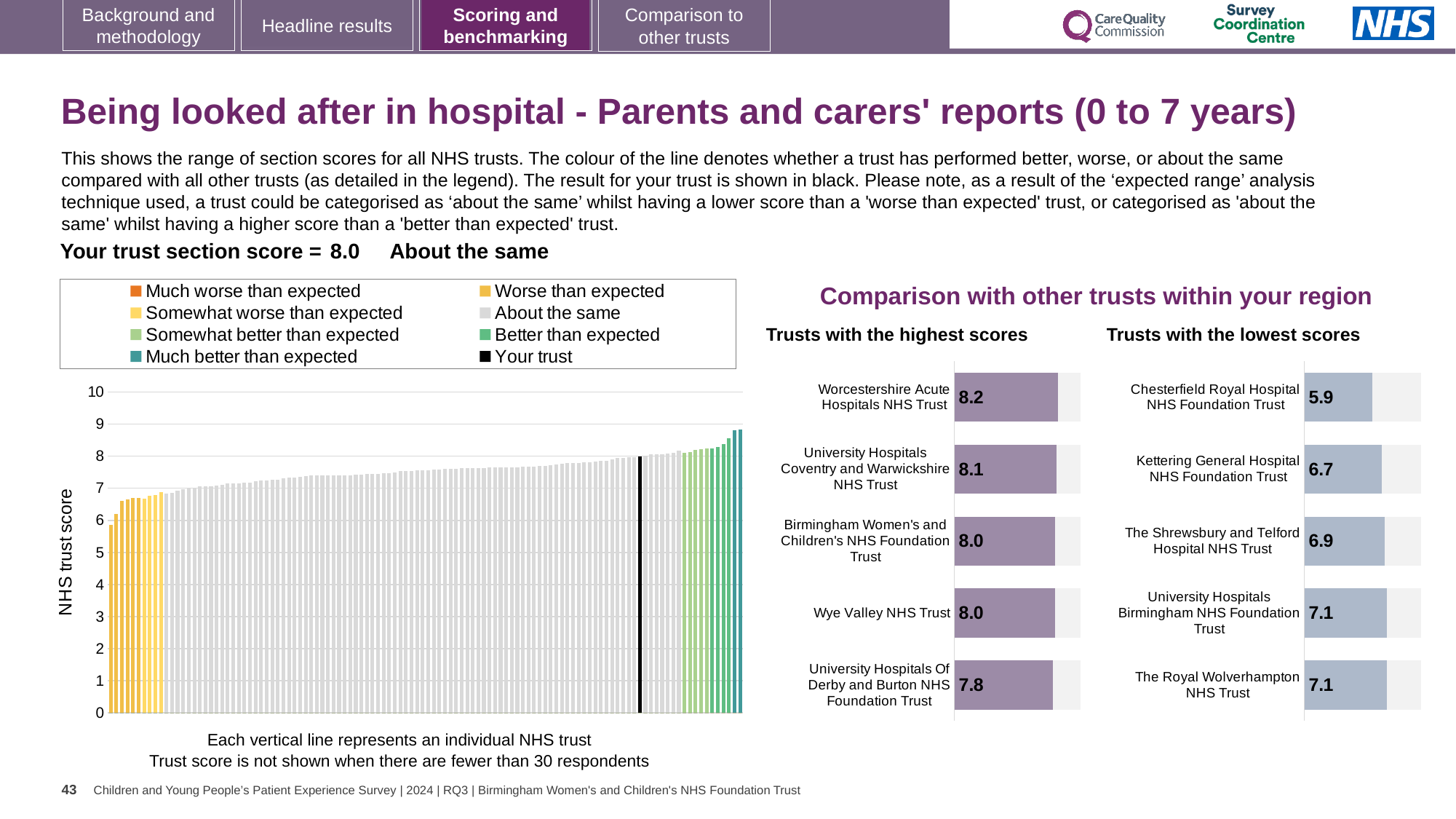
How many trusts are shown in the 'Trusts with the lowest scores' chart? 5 In the 'Trusts with the lowest scores' chart, what is the difference between the scores of Kettering General Hospital NHS Foundation Trust and Chesterfield Royal Hospital NHS Foundation Trust? 0.8 In the 'Trusts with the highest scores' chart, what is the score for Worcestershire Acute Hospitals NHS Trust? 8.2 What kind of chart is the large chart on the left showing NHS trust scores? Bar chart In the 'Trusts with the lowest scores' chart, what is the score for Kettering General Hospital NHS Foundation Trust? 6.7 In the 'Trusts with the highest scores' chart, which trust has the highest score? Worcestershire Acute Hospitals NHS Trust In the 'Trusts with the lowest scores' chart, which has the higher score: Kettering General Hospital NHS Foundation Trust or The Shrewsbury and Telford Hospital NHS Trust? The Shrewsbury and Telford Hospital NHS Trust In the large chart on the left, is the value of the tallest bar greater or less than 8? greater How many entries does the legend of the large chart on the left list? 8 In the 'Trusts with the lowest scores' chart, which trust has the lowest score? Chesterfield Royal Hospital NHS Foundation Trust In the 'Trusts with the highest scores' chart, what is the score for University Hospitals Of Derby and Burton NHS Foundation Trust? 7.8 In the 'Trusts with the highest scores' chart, what is the difference between the scores of Worcestershire Acute Hospitals NHS Trust and University Hospitals Of Derby and Burton NHS Foundation Trust? 0.4